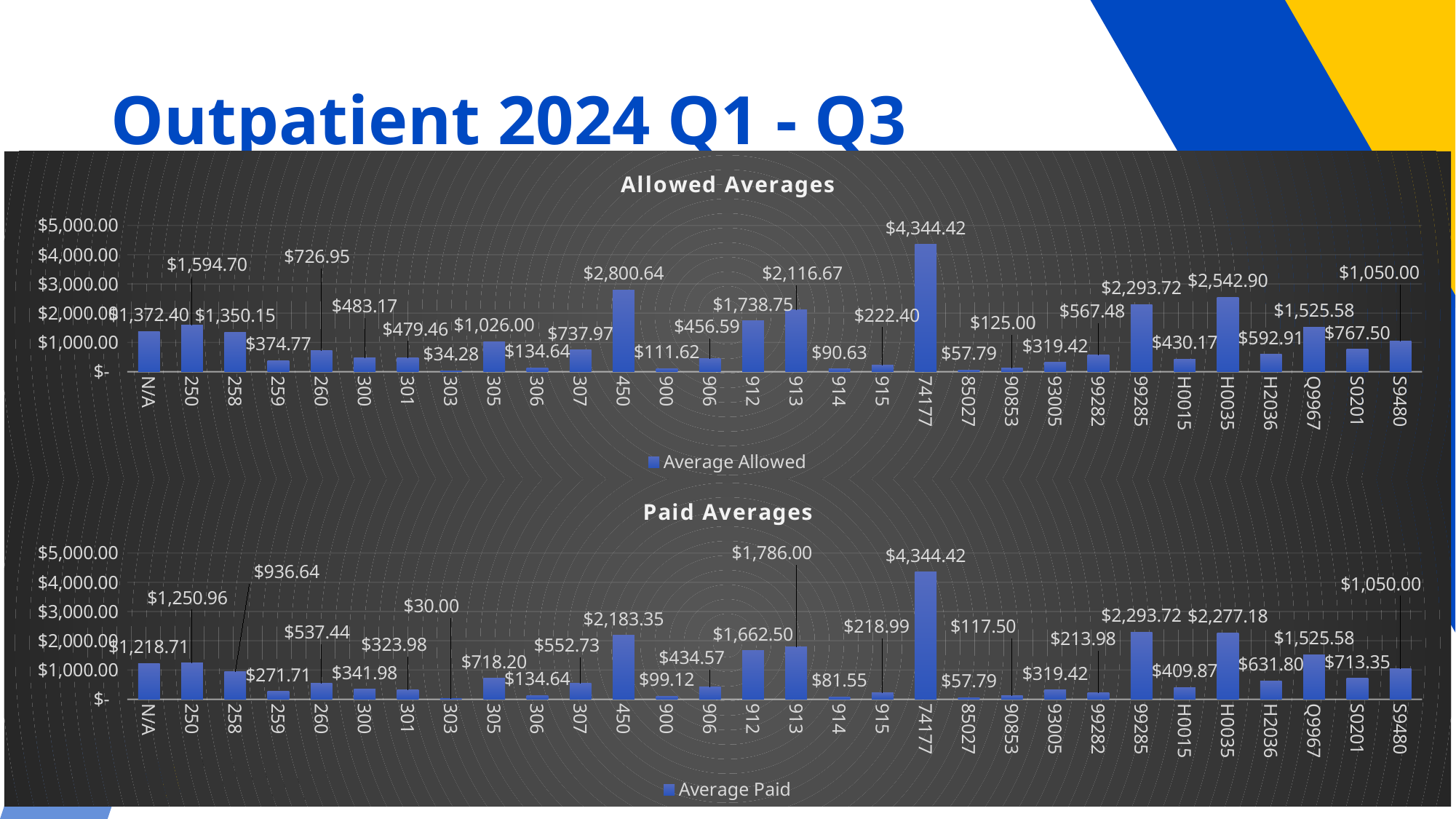
How many series does the legend of the Allowed Averages chart list? 1 In the Allowed Averages chart, what is the difference between the values for H0035 and 99285? $249.18 In the Allowed Averages chart, is the value for 913 greater or less than $1,000.00? greater What is the legend entry of the Paid Averages chart? Average Paid In the Paid Averages chart, what is the Average Paid value for 913? $1,786.00 How many categories are shown on the x axis of the Paid Averages chart? 30 In the Allowed Averages chart, what is the Average Allowed value for 303? $34.28 What kind of chart is the Paid Averages chart? bar chart In the Paid Averages chart, which category has the lowest Average Paid? 303 In the Allowed Averages chart, what is the Average Allowed value for 450? $2,800.64 In the Allowed Averages chart, which category has the highest Average Allowed? 74177 In the Paid Averages chart, which is larger, the value for 450 or the value for 99285? 99285